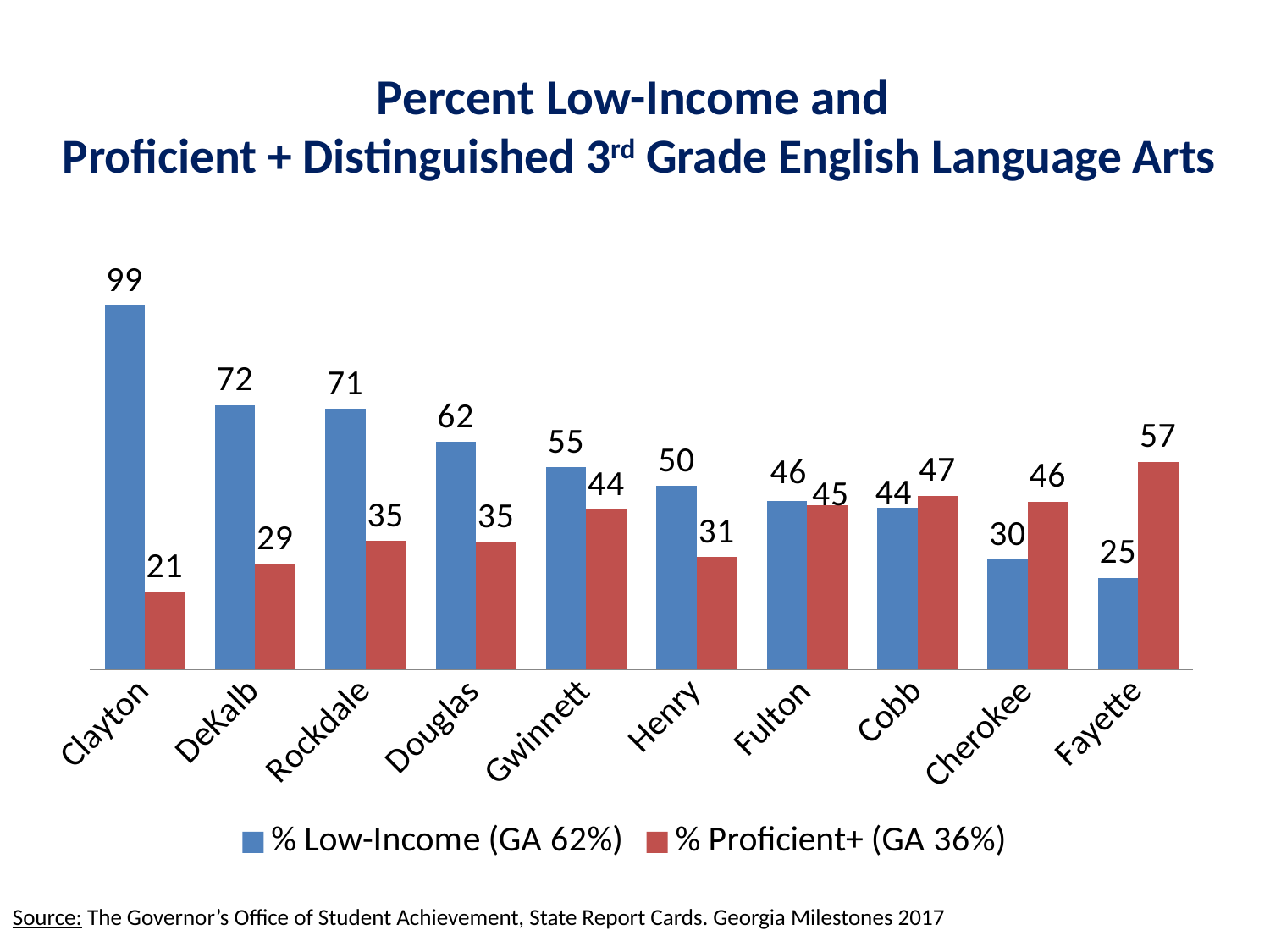
What is the % Low-Income value for Clayton? 99 What is the difference between the % Low-Income and % Proficient+ values for Clayton? 78 What is the % Proficient+ value for Fayette? 57 Which is larger for Henry: % Low-Income or % Proficient+? % Low-Income How many series does the legend list? 2 What kind of chart is shown on the slide? Bar chart What is the Georgia statewide % Proficient+ value given in the legend? 36% Which county has the highest % Low-Income value? Clayton What is the % Proficient+ value for Gwinnett? 44 How many counties are shown on the x axis? 10 Which county has the lowest % Low-Income value? Fayette Which county has the lowest % Proficient+ value? Clayton